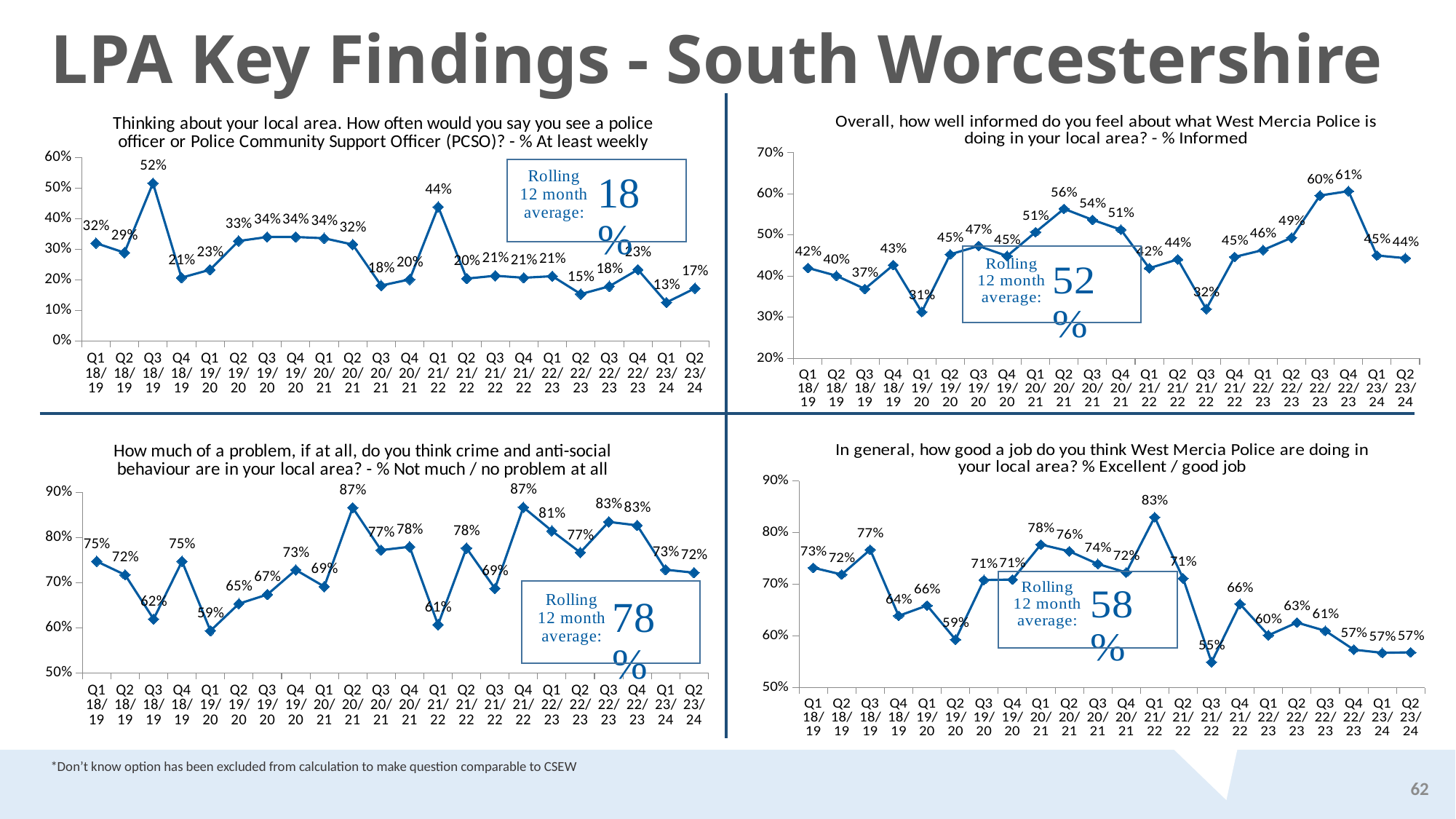
In the bottom-left chart (% Not much / no problem at all), what is the value for Q1 21/22? 61% In the top-right chart (% Informed), what is the value for Q4 22/23? 61% In the top-right chart (% Informed), which quarter has the lowest value? Q1 19/20 In the top-left chart (% seeing a police officer or PCSO at least weekly), which quarter has the lowest value? Q1 23/24 In the top-right chart (% Informed), what is the difference between Q2 20/21 and Q1 19/20? 25% What type of chart is the top-left chart (% seeing a police officer or PCSO at least weekly)? Line chart In the bottom-right chart (% Excellent / good job), which quarter has the highest value? Q1 21/22 In the top-left chart (% seeing a police officer or PCSO at least weekly), what is the value for Q3 18/19? 52% In the bottom-right chart (% Excellent / good job), what is the value for Q3 21/22? 55% In the top-left chart (% seeing a police officer or PCSO at least weekly), what is the rolling 12 month average shown? 18% How many quarters are plotted in the bottom-right chart (% Excellent / good job)? 22 In the bottom-left chart (% Not much / no problem at all), which is larger, Q4 21/22 or Q1 22/23? Q4 21/22